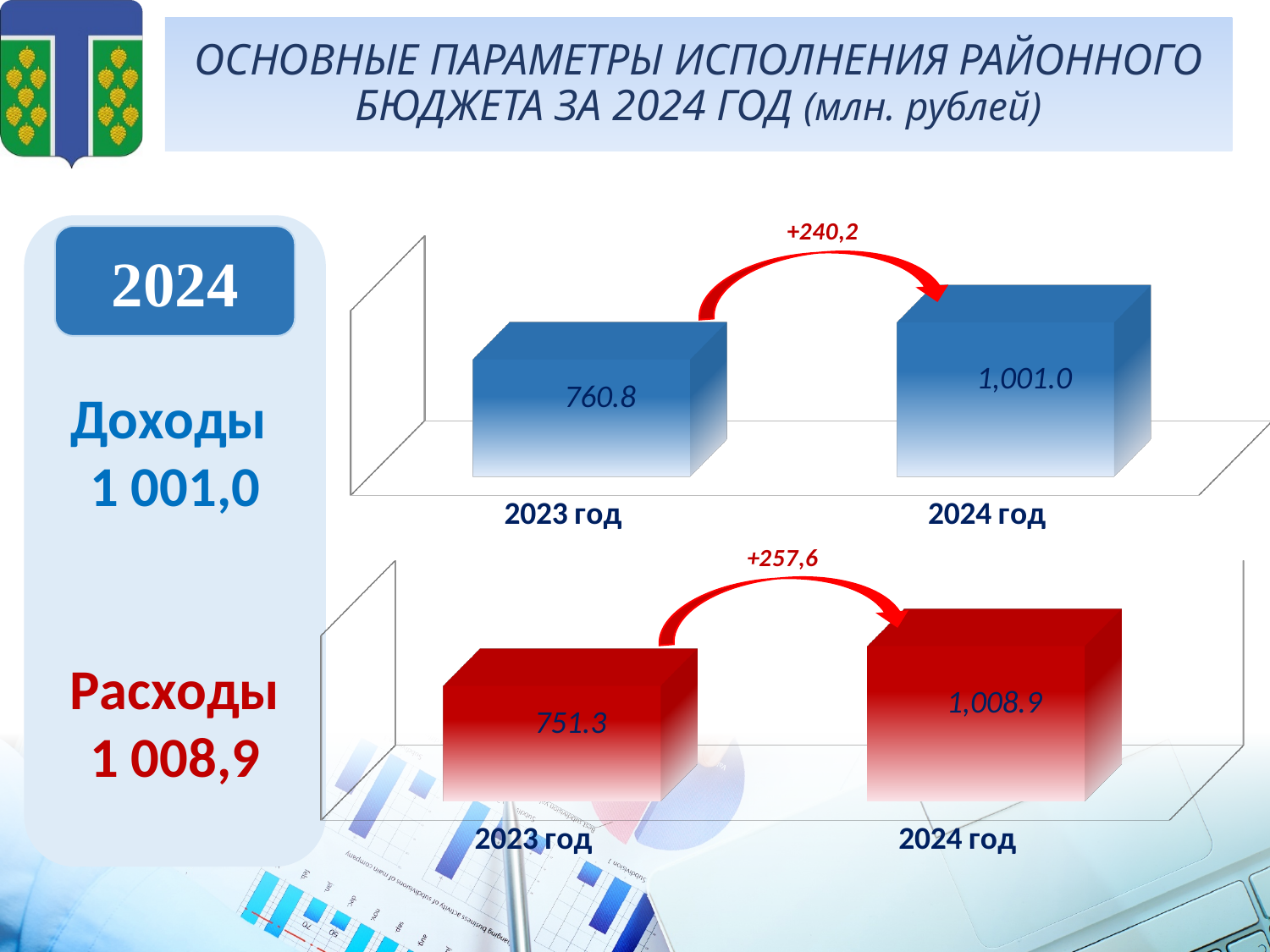
On the bottom (red) chart, what is the value for 2023 год? 751.3 On the top (blue) chart, what is the difference between the 2024 год and 2023 год values? 240.2 On the bottom (red) chart, which year has the lower value? 2023 год How many categories are shown on the top (blue) chart? 2 Is the 2024 год value on the bottom (red) chart larger or smaller than the 2024 год value on the top (blue) chart? larger On the top (blue) chart, what is the value for 2023 год? 760.8 On the bottom (red) chart, what is the difference between the 2024 год and 2023 год values? 257.6 What type of chart is the bottom (red) chart? bar chart On the top (blue) chart, which year has the higher value? 2024 год On the top (blue) chart, what is the value for 2024 год? 1,001.0 On the bottom (red) chart, what is the value for 2024 год? 1,008.9 On the top (blue) chart, do the values rise or fall from 2023 год to 2024 год? rise